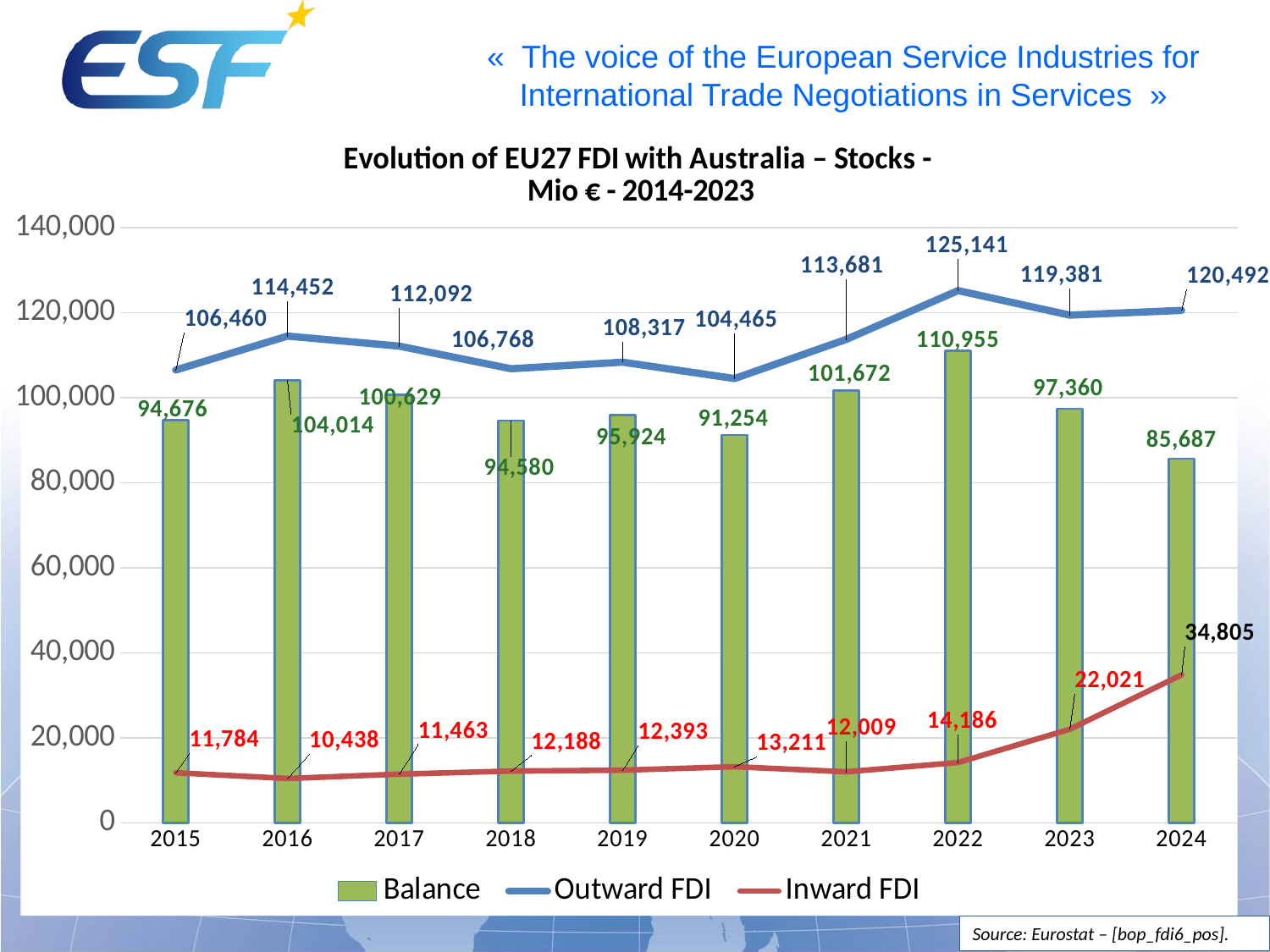
Which year has the larger Balance value, 2016 or 2021? 2016 What kind of chart is shown on the slide? Combined bar and line chart By how much did Inward FDI increase from 2023 to 2024? 12,784 Does Inward FDI rise or fall from 2021 to 2024? Rise How many years are shown on the x axis? 10 What is the Balance value for 2024? 85,687 What is the Outward FDI value for 2022? 125,141 In which year is the Inward FDI value lowest? 2016 How many series does the legend list? 3 In which year is Outward FDI highest? 2022 What is the Inward FDI value for 2023? 22,021 What is the difference between Outward FDI and Inward FDI in 2024? 85,687